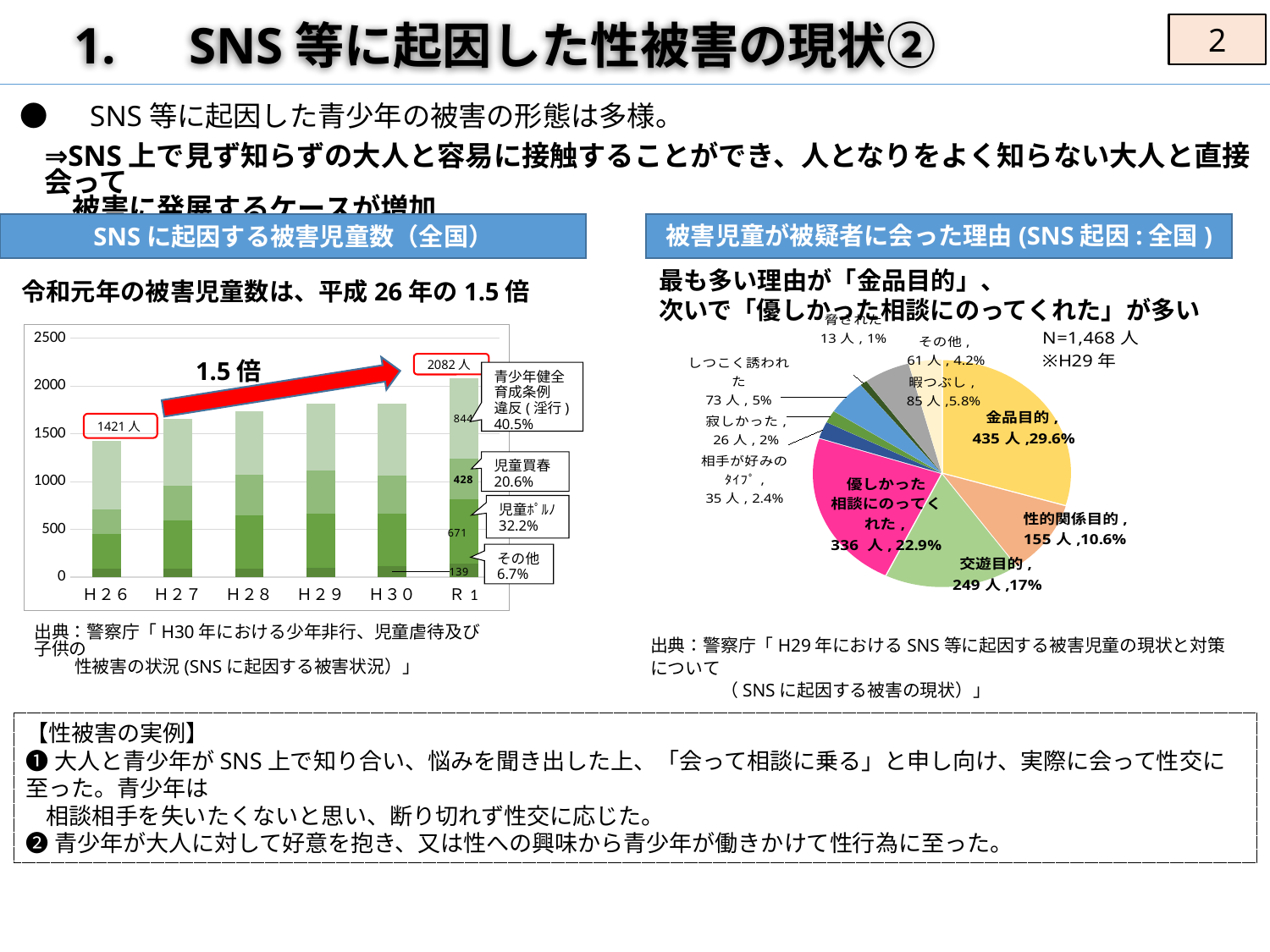
In the left bar chart, what is the total number of victimized children labeled for H26? 1421人 In the right pie chart, what share of the pie does 優しかった相談にのってくれた represent? 22.9% In the left bar chart, what is the total number of victimized children labeled for R1? 2082人 In the left bar chart, what is the difference between the R1 total (2082人) and the H26 total (1421人)? 661人 In the left bar chart, what is the value of the 児童買春 segment for R1? 428 What kind of chart is the left chart titled 「SNSに起因する被害児童数（全国）」? bar chart In the right pie chart, which is larger, 交遊目的 or 性的関係目的? 交遊目的 In the left bar chart, how many years (categories) are shown on the x axis? 6 In the right pie chart, which reason has the largest slice? 金品目的 What kind of chart is the right chart titled 「被害児童が被疑者に会った理由(SNS起因:全国)」? pie chart In the left bar chart, is the total for H28 greater or less than 1500? greater In the right pie chart, how many people are in the 金品目的 slice? 435人